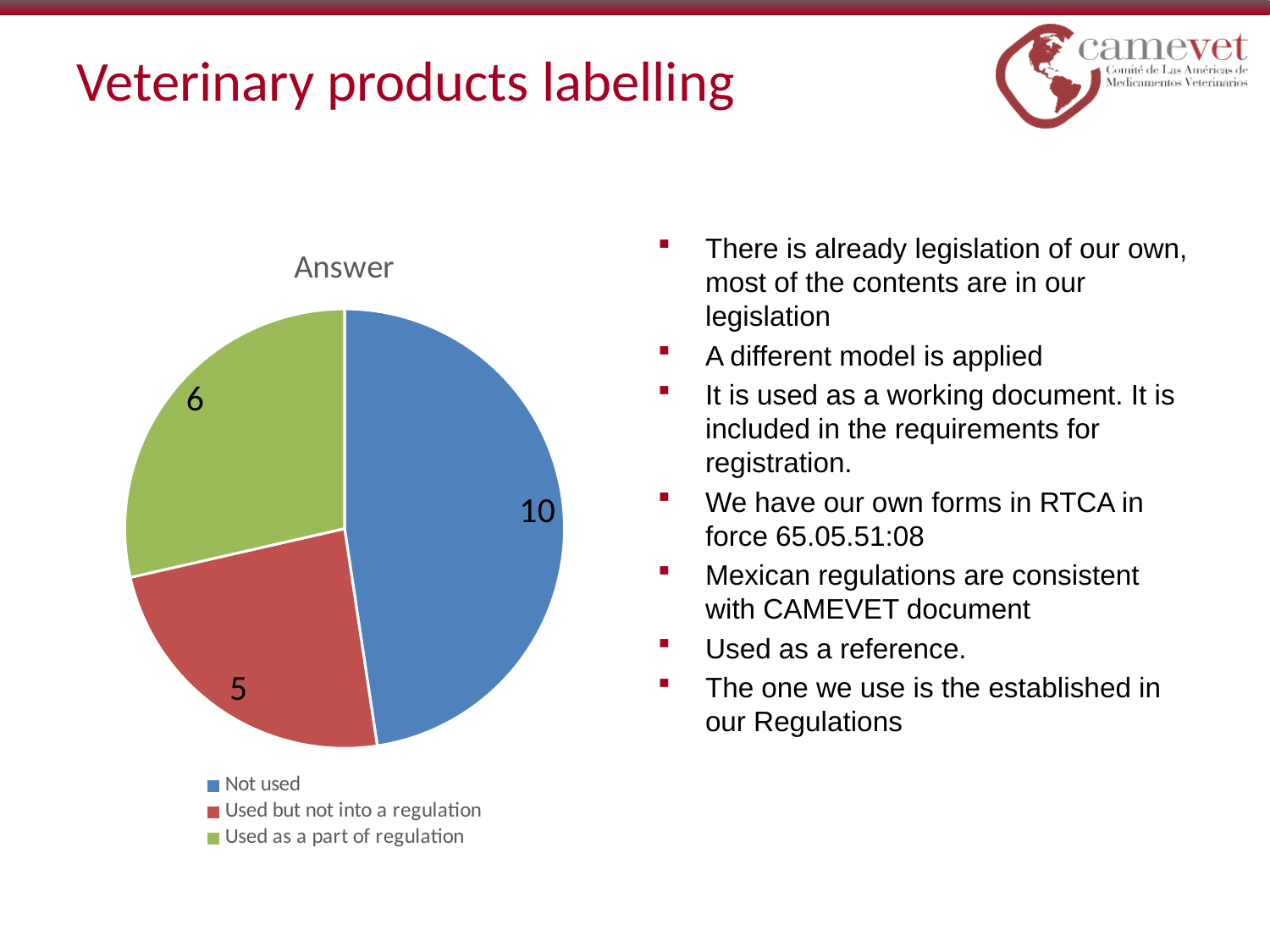
Which category has the smallest slice? Used but not into a regulation Which is larger, "Used as a part of regulation" or "Used but not into a regulation"? Used as a part of regulation What is the total of all slices in the pie chart? 21 What is the value for "Not used"? 10 What colour is the "Not used" slice? blue Which category has the largest slice? Not used What is the value for "Used but not into a regulation"? 5 What is the title of the chart? Answer What is the difference between the values for "Not used" and "Used as a part of regulation"? 4 How many categories does the pie chart have? 3 What is the value for "Used as a part of regulation"? 6 What kind of chart is shown on the slide? pie chart